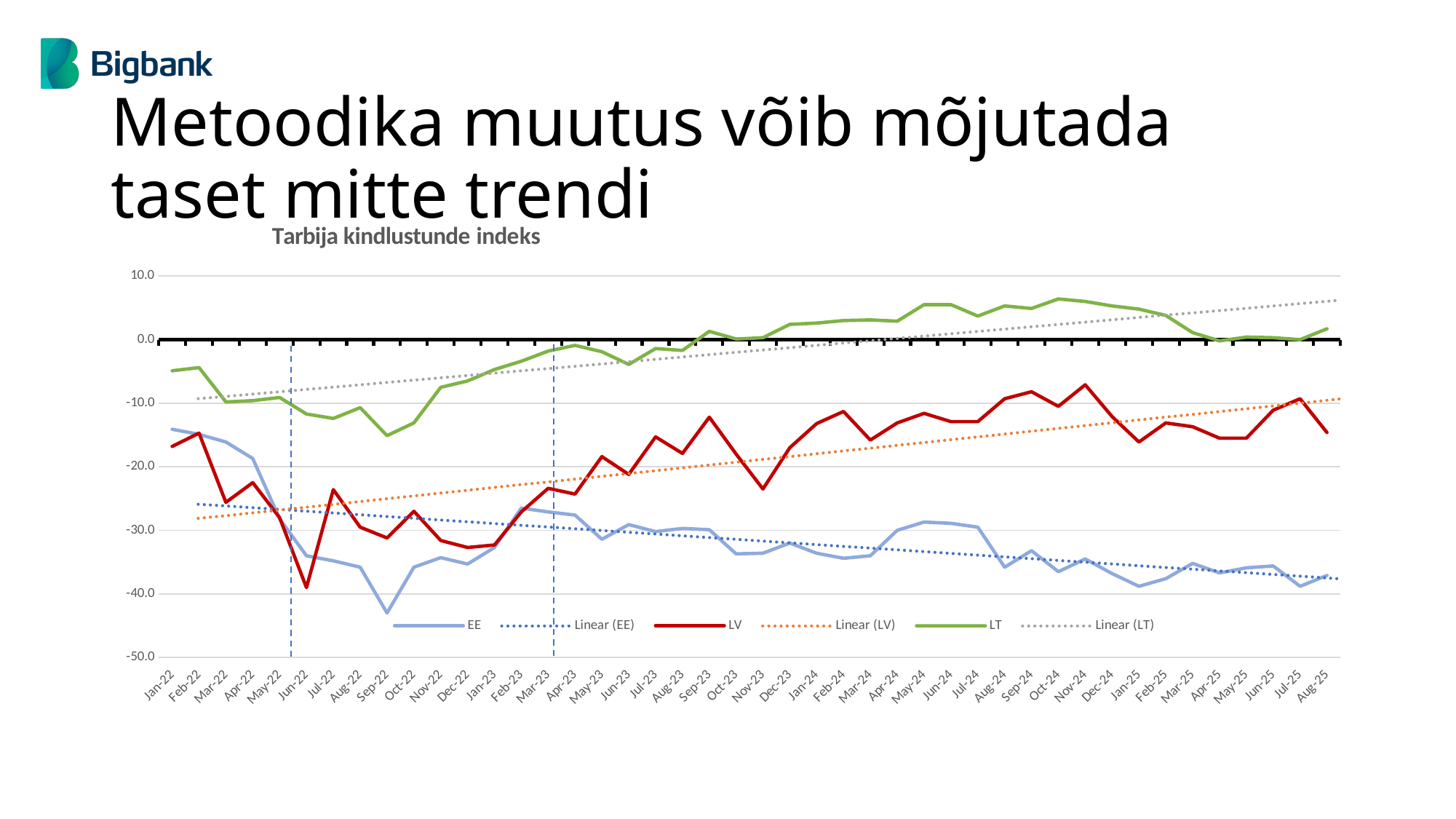
Which series is plotted with a green line? LT Is the value for LV in Jun-22 greater or less than -30? less How many entries does the legend of the chart list? 6 Is the value for EE in Sep-22 greater or less than -40? less Which series has the lowest value in Sep-22? EE Is the value for LT in Oct-24 greater or less than 0? greater What is the title of the chart? Tarbija kindlustunde indeks Which series has the highest value in Aug-25? LT What kind of chart is shown on the slide? line chart Does the Linear (EE) trendline rise or fall from left to right? fall In Aug-25, which is larger, the value for LV or the value for EE? LV